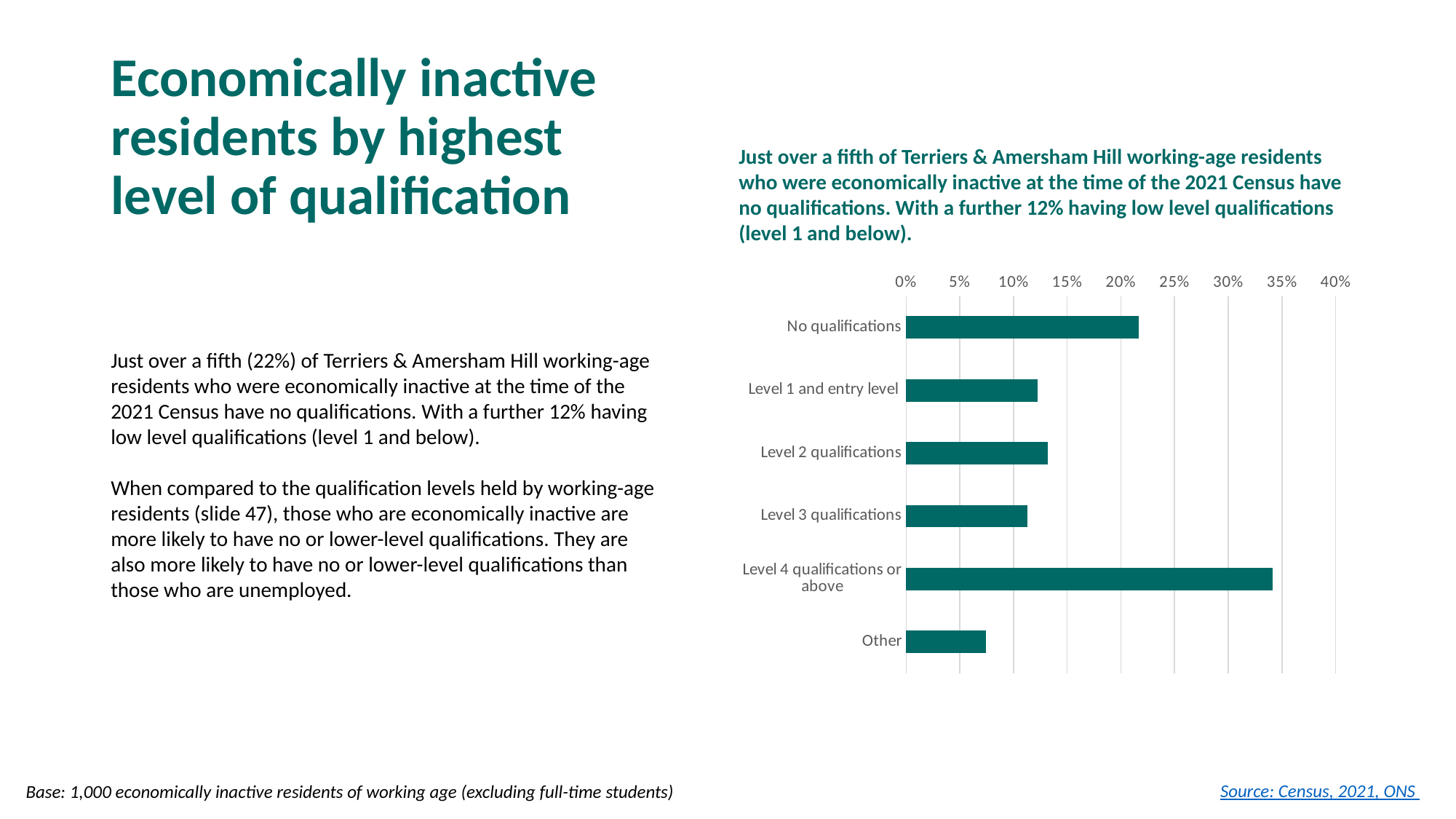
Is the value for No qualifications greater or less than 20%? greater Which qualification category has the highest share of economically inactive residents? Level 4 qualifications or above Is the value for Other greater or less than 10%? less Which qualification category has the lowest share of economically inactive residents? Other Which is larger: the value for Level 4 qualifications or above, or the value for No qualifications? Level 4 qualifications or above Is the value for Level 4 qualifications or above greater or less than 30%? greater What is the highest value shown on the chart's percentage axis? 40% What colour are the bars in the chart? Dark teal How many qualification categories are plotted in the chart? 6 What kind of chart is shown on the slide? Bar chart Which is larger: the value for Level 3 qualifications or the value for Other? Level 3 qualifications